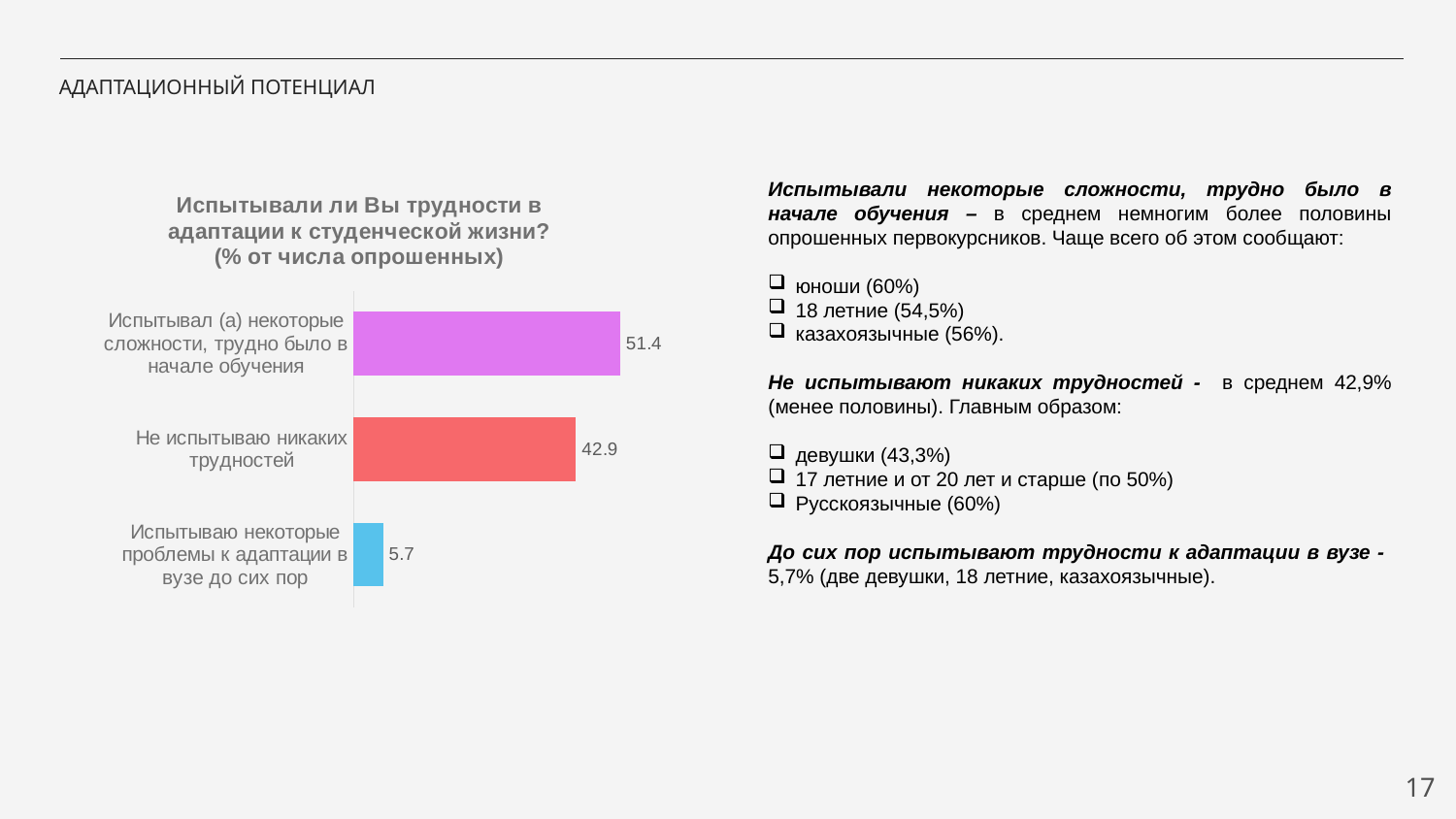
What is the value for "Испытываю некоторые проблемы к адаптации в вузе до сих пор"? 5.7 What is the value for "Испытывал (а) некоторые сложности, трудно было в начале обучения"? 51.4 What colour is the bar for "Не испытываю никаких трудностей"? Red Which category has the lowest value? Испытываю некоторые проблемы к адаптации в вузе до сих пор How many categories are shown in the chart? 3 What is the difference between the values for "Не испытываю никаких трудностей" and "Испытываю некоторые проблемы к адаптации в вузе до сих пор"? 37.2 What is the difference between the values for "Испытывал (а) некоторые сложности, трудно было в начале обучения" and "Не испытываю никаких трудностей"? 8.5 What kind of chart is shown on the slide? Bar chart What is the value for "Не испытываю никаких трудностей"? 42.9 What is the title of the chart? Испытывали ли Вы трудности в адаптации к студенческой жизни? (% от числа опрошенных) Which is larger: the value for "Не испытываю никаких трудностей" or for "Испытываю некоторые проблемы к адаптации в вузе до сих пор"? Не испытываю никаких трудностей Which category has the highest value? Испытывал (а) некоторые сложности, трудно было в начале обучения